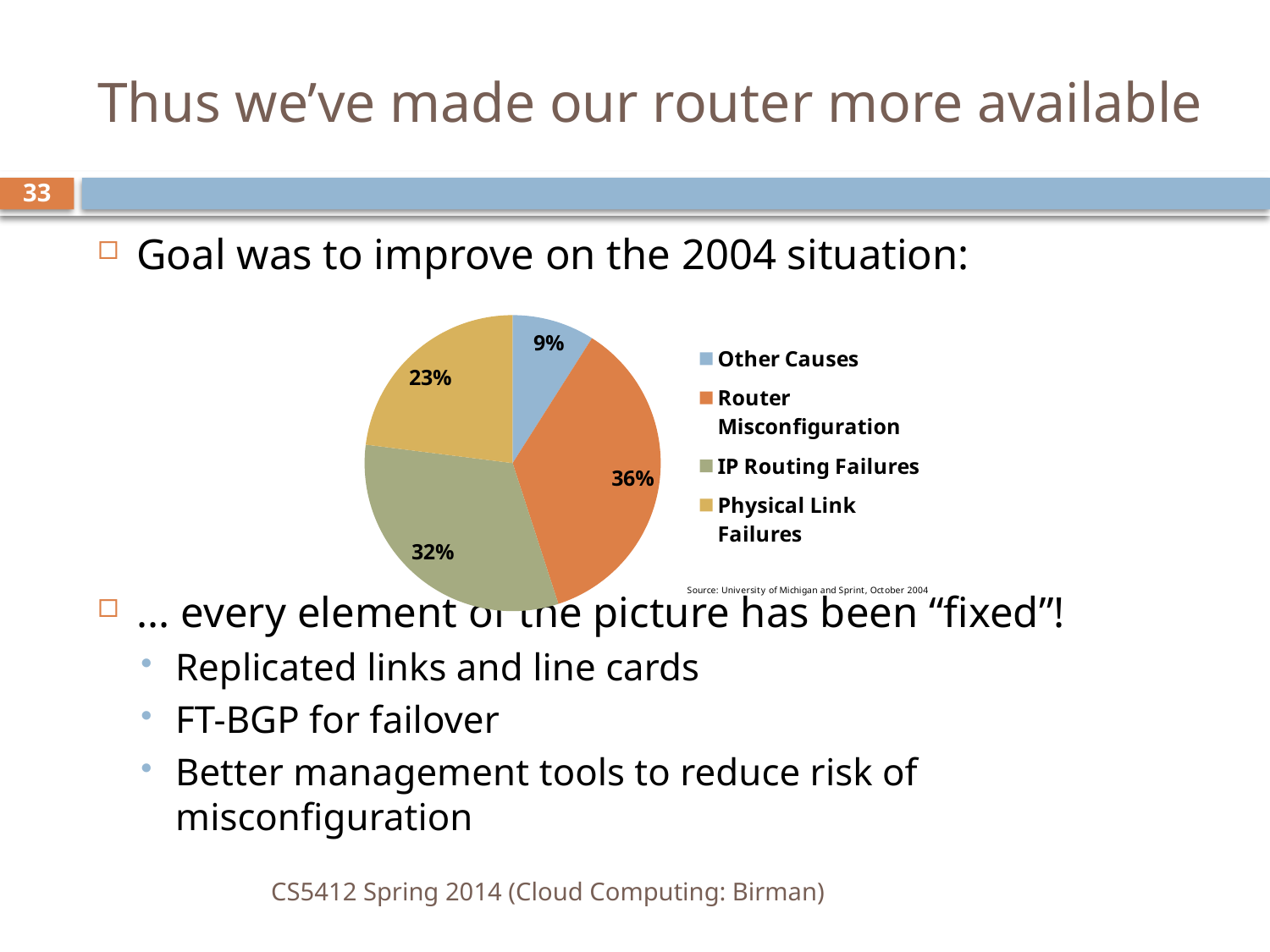
What kind of chart is shown on the slide? pie chart Which category has the smallest slice of the pie? Other Causes How many categories does the pie chart have? 4 What share of the pie is Other Causes? 9% What share of the pie is Router Misconfiguration? 36% What colour is the slice for IP Routing Failures? green Which is larger, the share for IP Routing Failures or the share for Physical Link Failures? IP Routing Failures What share of the pie is IP Routing Failures? 32% What is the difference in percentage points between Router Misconfiguration and Physical Link Failures? 13 What source is cited below the pie chart? University of Michigan and Sprint, October 2004 Which category has the largest slice of the pie? Router Misconfiguration